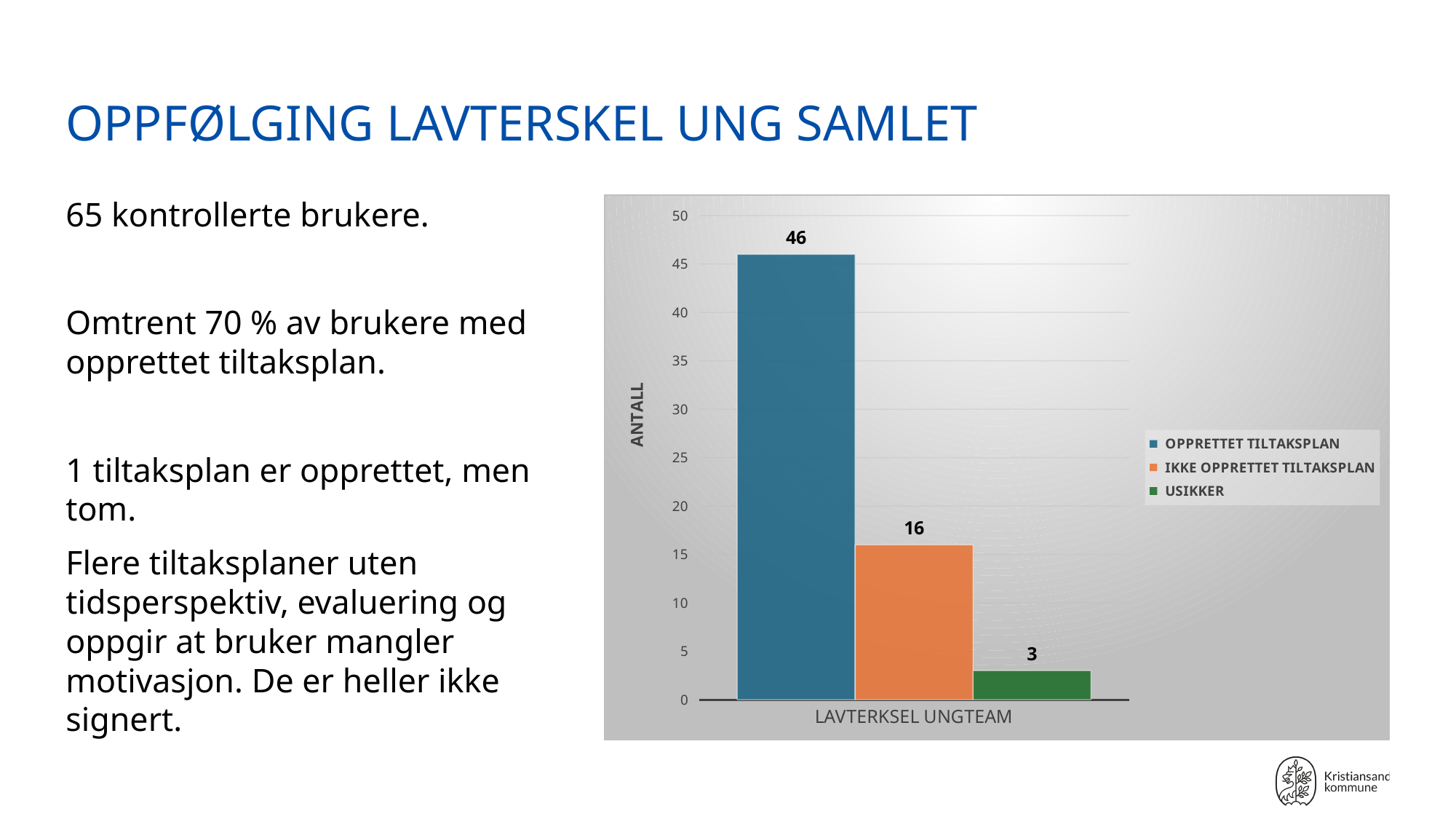
How many series does the legend list? 3 Which is larger, IKKE OPPRETTET TILTAKSPLAN or USIKKER? IKKE OPPRETTET TILTAKSPLAN What is the value for IKKE OPPRETTET TILTAKSPLAN? 16 What kind of chart is shown? bar chart Is the value for OPPRETTET TILTAKSPLAN greater or less than 40? greater What is the label on the vertical axis? ANTALL Which series has the highest value? OPPRETTET TILTAKSPLAN What is the difference between IKKE OPPRETTET TILTAKSPLAN and USIKKER? 13 What is the difference between OPPRETTET TILTAKSPLAN and IKKE OPPRETTET TILTAKSPLAN? 30 What is the value for OPPRETTET TILTAKSPLAN? 46 What is the value for USIKKER? 3 Which series has the lowest value? USIKKER